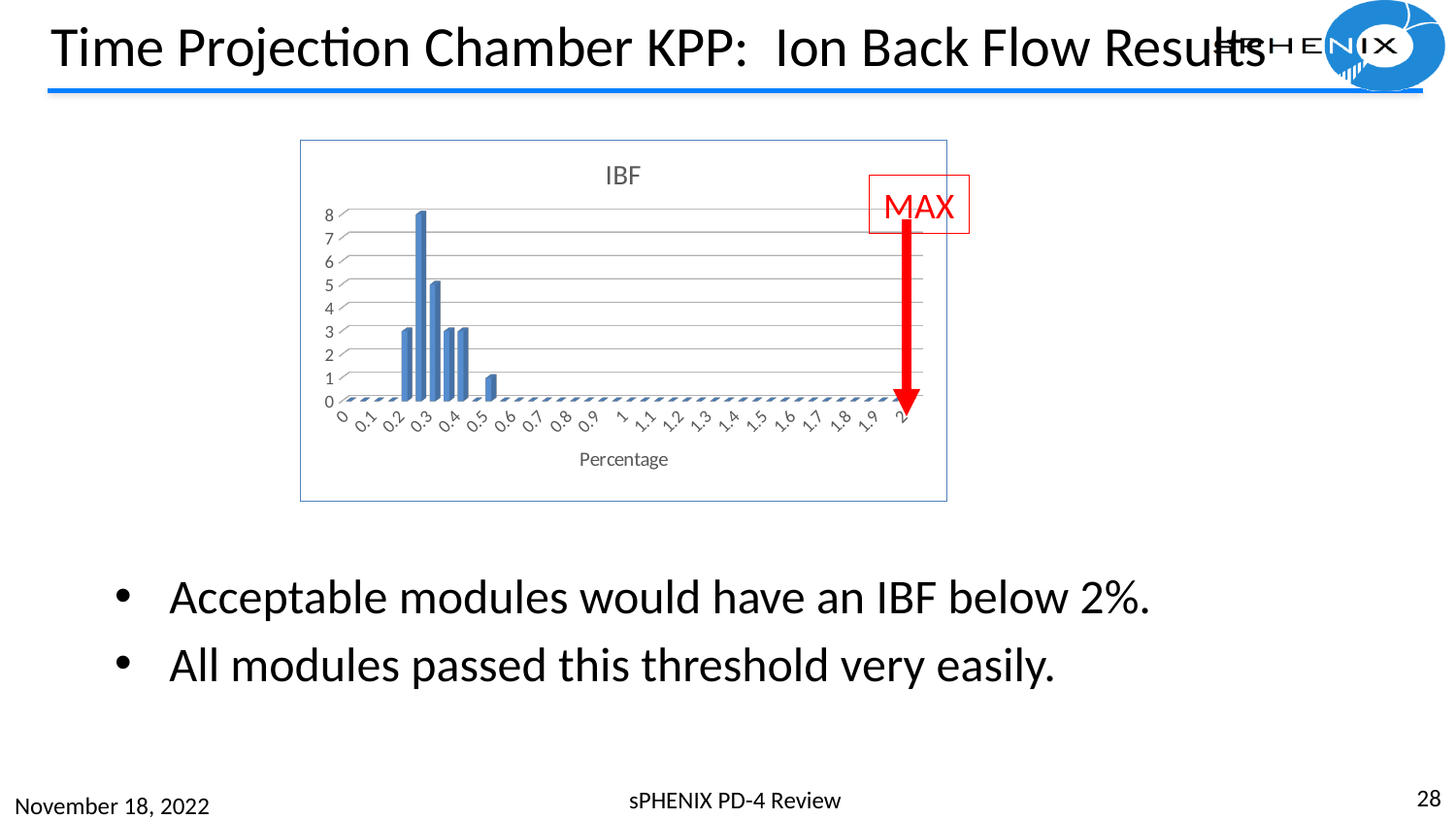
What kind of chart is shown on the slide? bar chart What is the highest tick value shown on the y axis? 8 What is the label on the x axis of the chart? Percentage Is the shortest bar in the chart greater or less than 2? less How many category labels are shown along the x axis of the chart? 21 Is the tallest bar in the chart greater or less than 5? greater What is the title of the chart? IBF How many bars are plotted in the chart? 6 What value does the shortest bar in the chart reach? 1 What is the last label shown on the x axis? 2 Are there any bars plotted at x-axis values of 1 or higher? No What value does the tallest bar in the chart reach? 8